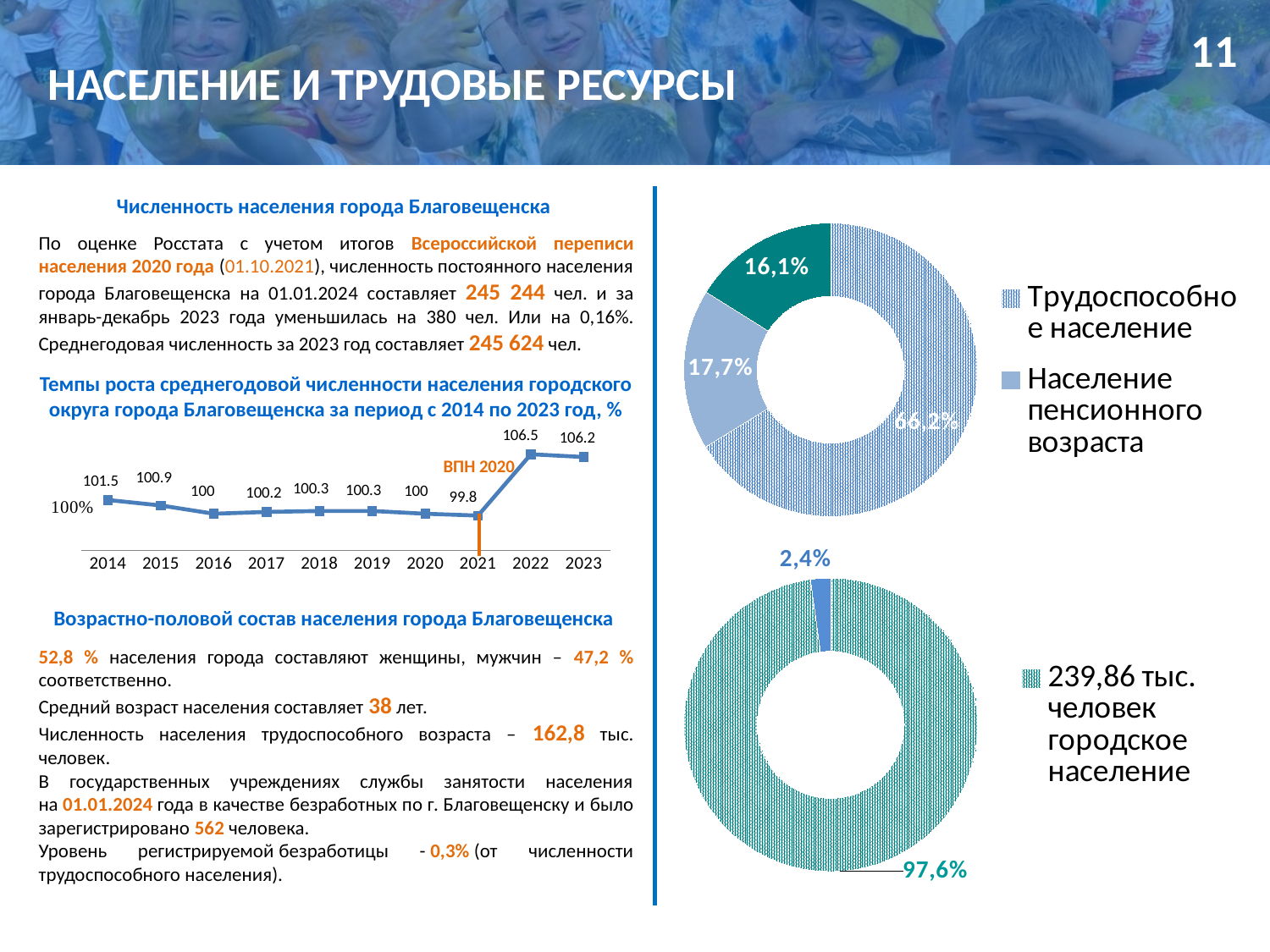
On the top-right donut chart, what share is 'Трудоспособное население'? 66,2% What kind of chart shows the growth rates from 2014 to 2023? line chart On the line chart 'Темпы роста среднегодовой численности населения', what is the difference between the values for 2022 and 2021? 6.7 On the line chart 'Темпы роста среднегодовой численности населения', what is the value for 2022? 106.5 On the top-right donut chart, what share is 'Население пенсионного возраста'? 17,7% On the line chart 'Темпы роста среднегодовой численности населения', how many years are plotted? 10 On the line chart 'Темпы роста среднегодовой численности населения', what is the value for 2014? 101.5 On the line chart 'Темпы роста среднегодовой численности населения', is the value for 2023 higher or lower than the value for 2015? higher On the line chart 'Темпы роста среднегодовой численности населения', which year has the lowest value? 2021 On the bottom-right donut chart, what share is '239,86 тыс. человек городское население'? 97,6% On the line chart 'Темпы роста среднегодовой численности населения', which year has the highest value? 2022 On the top-right donut chart, how many slices are there? 3